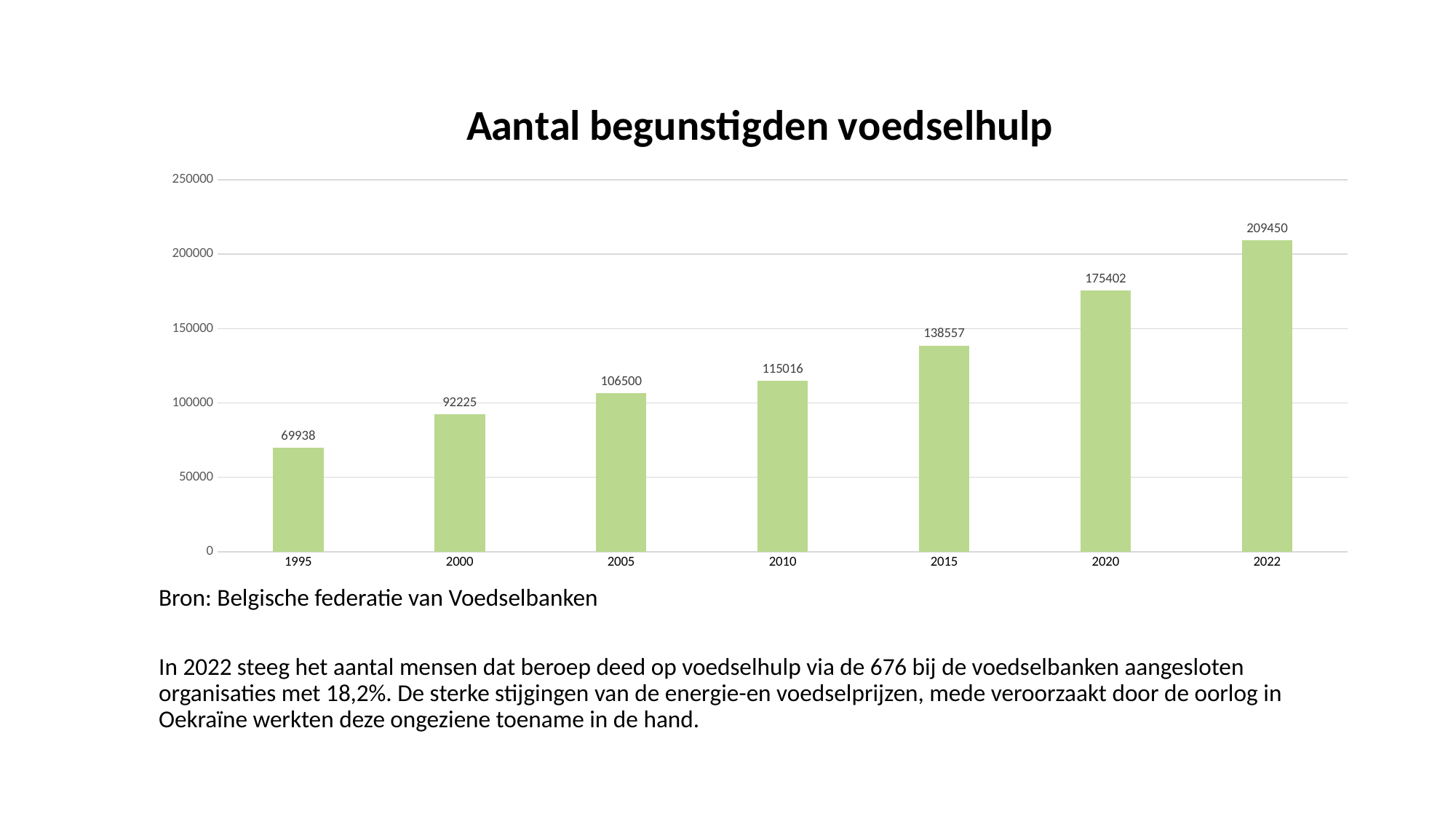
Which year has the highest value? 2022 What is the value for 2022? 209450 What is the difference between the values for 2022 and 2020? 34048 What kind of chart is shown? bar chart Which is larger, the value for 2005 or the value for 2015? 2015 What is the value for 2010? 115016 How many years are shown on the x axis? 7 What is the value for 1995? 69938 Do the values rise or fall from 1995 to 2022? rise Is the value for 2020 greater or less than 150000? greater Which year has the lowest value? 1995 What is the difference between the values for 2000 and 1995? 22287